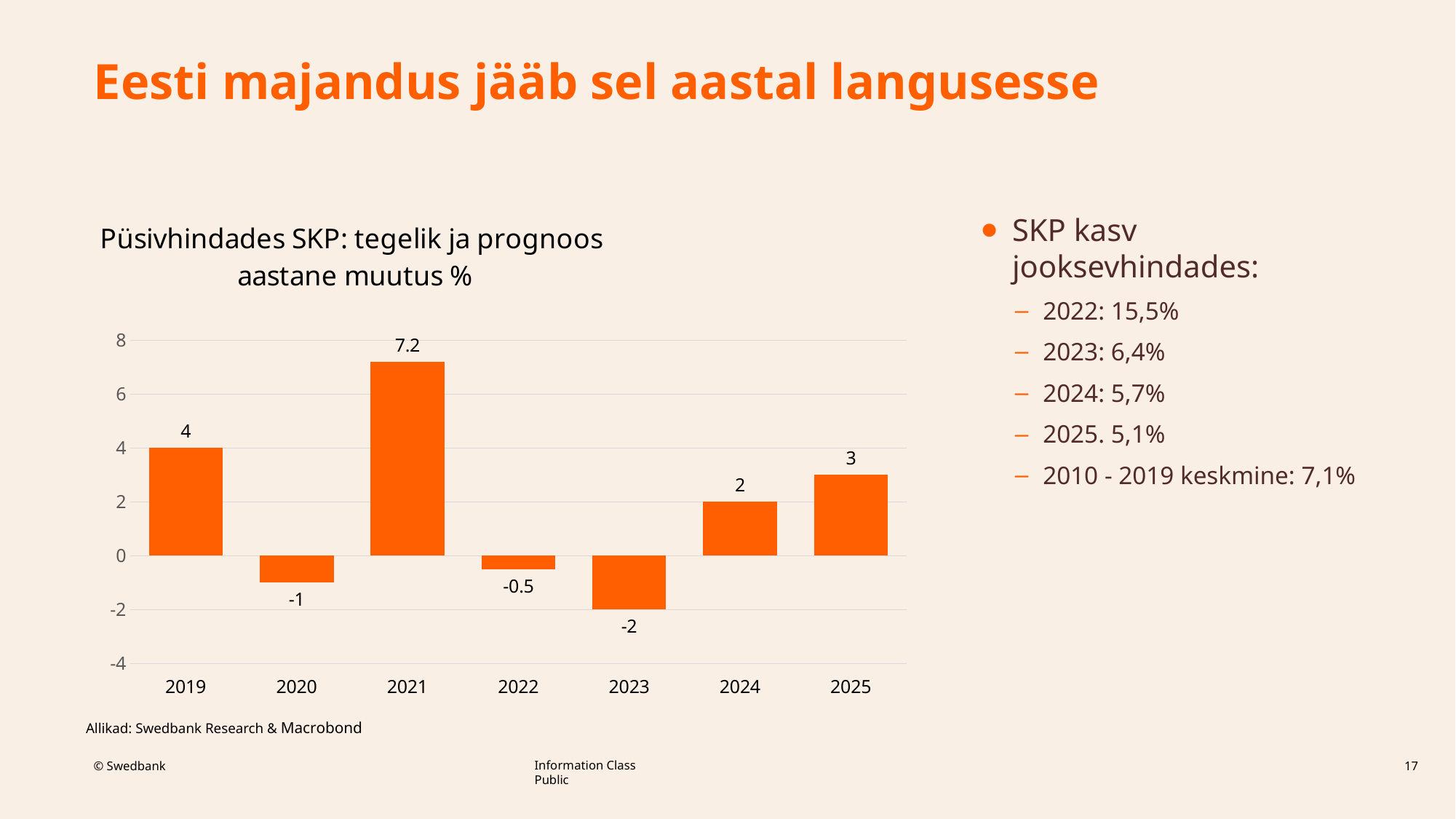
What kind of chart is shown? bar chart What is the difference between the values for 2021 and 2019? 3.2 Which year has the highest value? 2021 How many years are shown on the x axis? 7 What is the value for 2022? -0.5 Which year has the lowest value? 2023 What is the title of the chart? Püsivhindades SKP: tegelik ja prognoos aastane muutus % Is the value for 2021 greater or less than 6? greater What is the value for 2023? -2 What is the value for 2021? 7.2 Do the values rise or fall from 2023 to 2025? rise Which is larger, the value for 2024 or the value for 2025? 2025